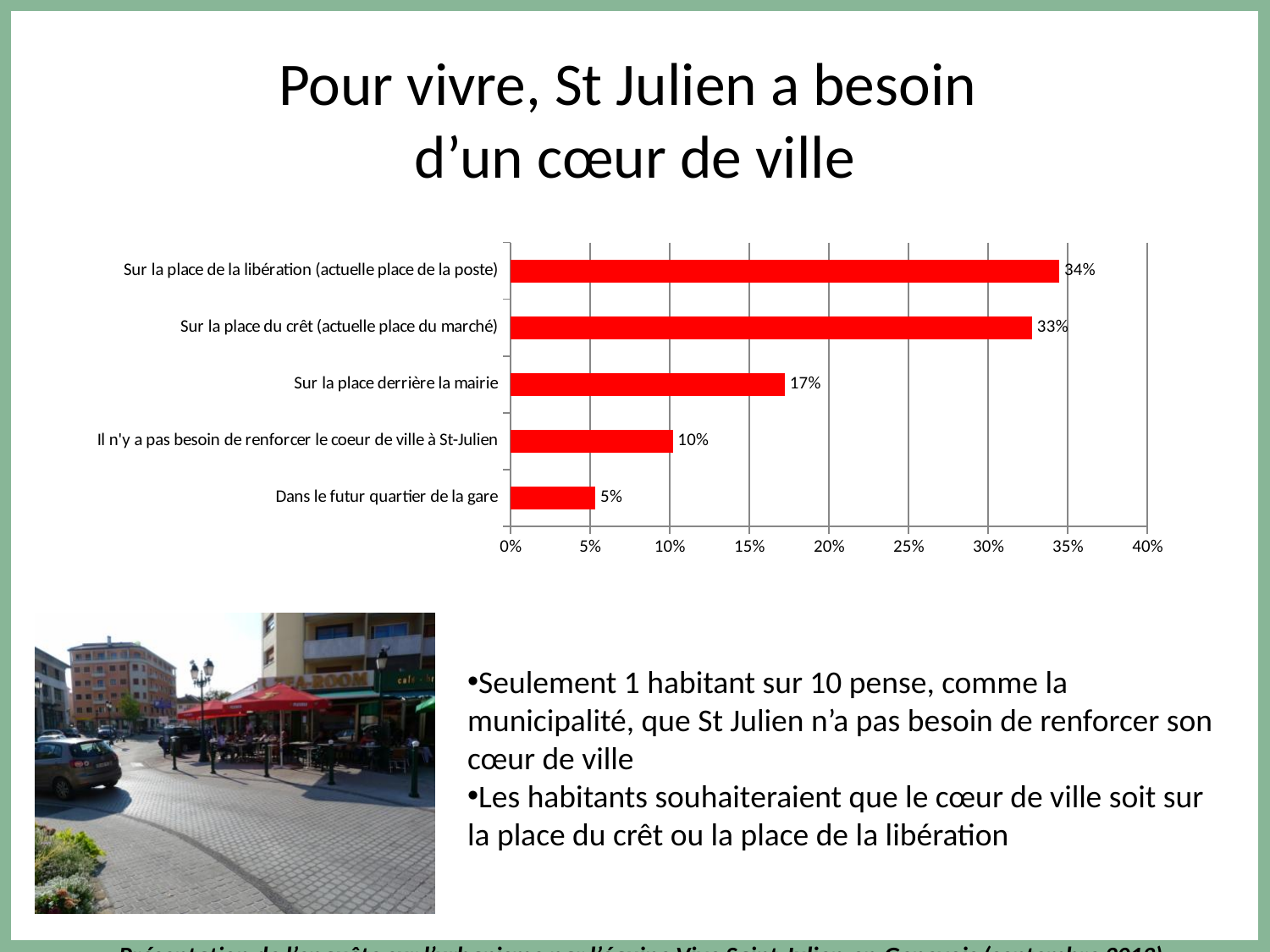
What percentage of respondents chose "Dans le futur quartier de la gare"? 5% What type of chart is shown on the slide? Bar chart What percentage of respondents chose "Sur la place de la libération (actuelle place de la poste)"? 34% Which category has the lowest value in the chart? Dans le futur quartier de la gare What is the value shown for "Sur la place du crêt (actuelle place du marché)"? 33% What percentage is shown for "Sur la place derrière la mairie"? 17% Which category has the highest value in the chart? Sur la place de la libération (actuelle place de la poste) How many categories are shown in the chart? 5 Which is larger: the value for "Sur la place derrière la mairie" or the value for "Il n'y a pas besoin de renforcer le coeur de ville à St-Julien"? Sur la place derrière la mairie What is the value for "Il n'y a pas besoin de renforcer le coeur de ville à St-Julien"? 10% What colour are the bars in the chart? Red What is the difference between the values for "Sur la place derrière la mairie" and "Dans le futur quartier de la gare"? 12%